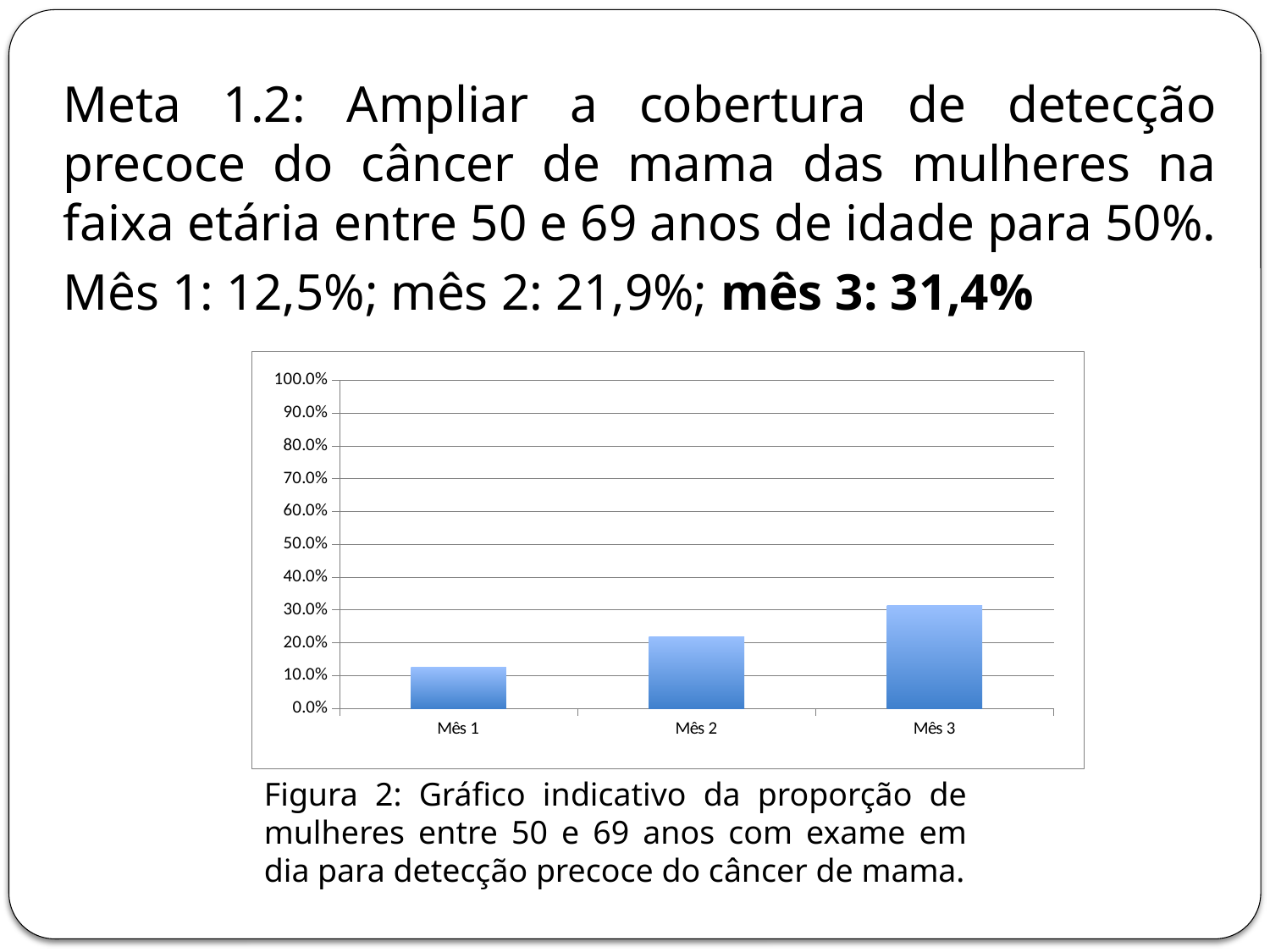
How many bars (months) are plotted in the chart? 3 What is the value for Mês 3 according to the slide? 31,4% Do the values rise or fall from Mês 1 to Mês 3? rise Is the value for Mês 1 greater or less than 20.0%? less Which month has the highest bar in the chart? Mês 3 Is the value for Mês 3 greater or less than 20.0%? greater Which is larger, the value for Mês 2 or the value for Mês 3? Mês 3 What kind of chart is shown on the slide? bar chart What is the value for Mês 1 according to the slide? 12,5% What is the highest value shown on the chart's vertical axis? 100.0% What is the difference between the values for Mês 3 and Mês 1 as given on the slide? 18,9% Which month has the lowest bar in the chart? Mês 1